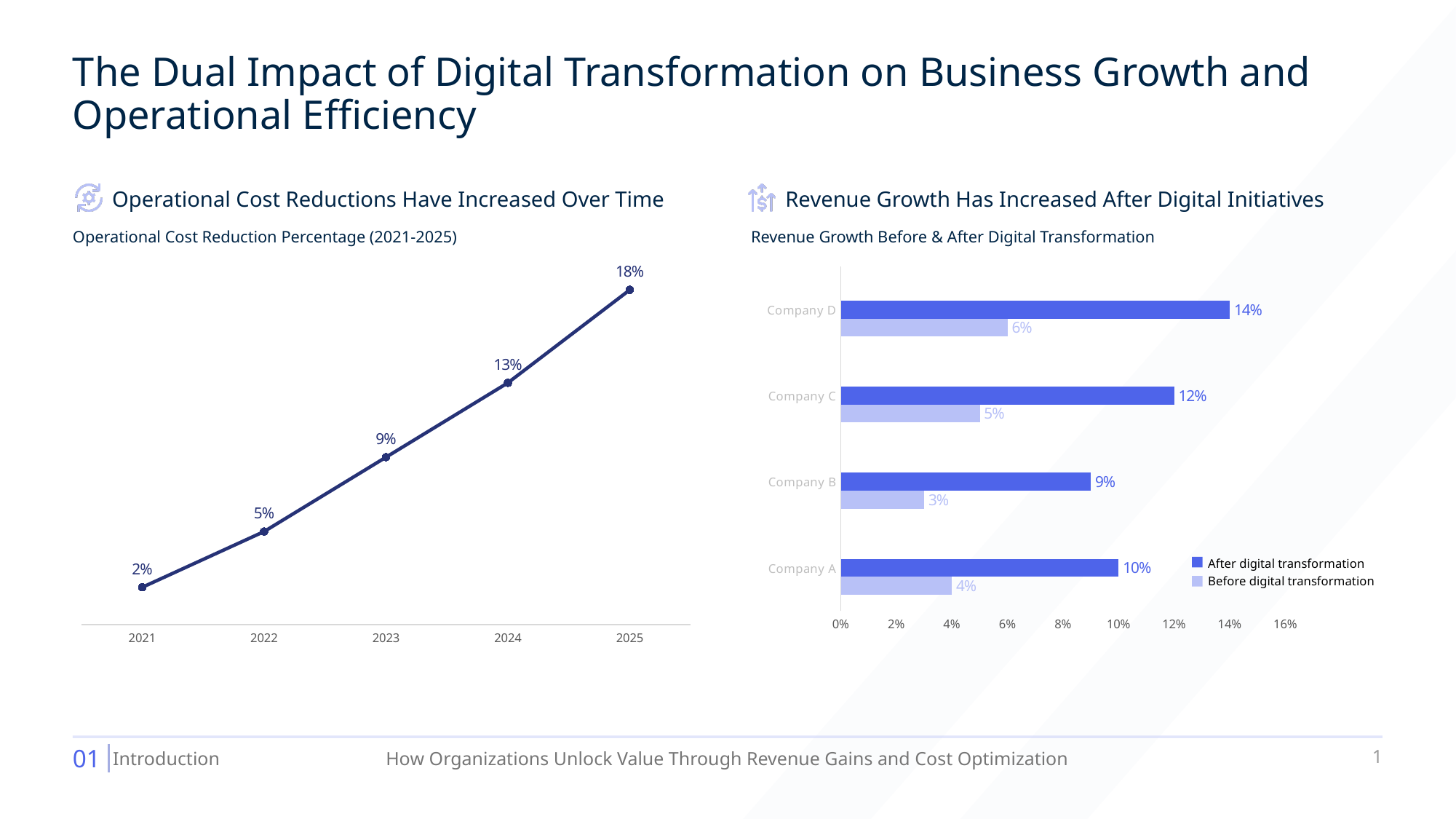
How many years are plotted in the Operational Cost Reduction Percentage (2021-2025) chart? 5 In the Revenue Growth Before & After Digital Transformation chart, which company has the lowest value before digital transformation? Company B In the Revenue Growth Before & After Digital Transformation chart, what is the value for Company C after digital transformation? 12% In the Operational Cost Reduction Percentage (2021-2025) chart, which year has the highest value? 2025 In the Operational Cost Reduction Percentage (2021-2025) chart, do the values rise or fall from 2021 to 2025? rise What kind of chart is the Operational Cost Reduction Percentage (2021-2025) chart? line chart How many series does the legend list in the Revenue Growth Before & After Digital Transformation chart? 2 In the Operational Cost Reduction Percentage (2021-2025) chart, what is the value for 2023? 9% In the Revenue Growth Before & After Digital Transformation chart, which is larger: Company A after digital transformation or Company B after digital transformation? Company A after digital transformation What kind of chart is the Revenue Growth Before & After Digital Transformation chart? bar chart In the Revenue Growth Before & After Digital Transformation chart, what is the difference between Company D's after and before values? 8% In the Operational Cost Reduction Percentage (2021-2025) chart, what is the difference between the 2025 and 2021 values? 16%